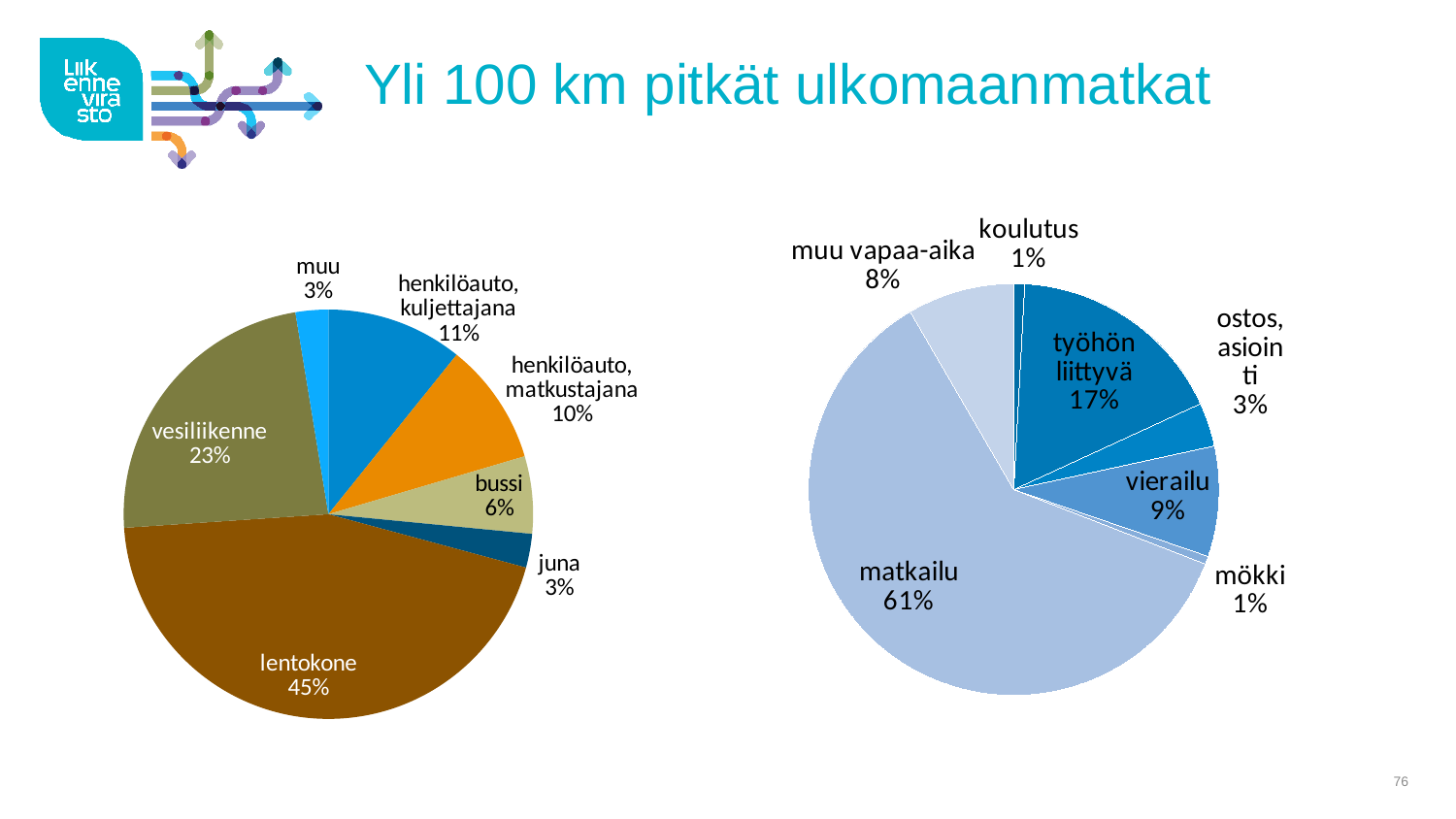
In the left pie chart, which category has the largest share? lentokone In the left pie chart, what is the share for vesiliikenne? 23% How many slices does the left pie chart have? 7 In the right pie chart, what is the share for työhön liittyvä? 17% In the left pie chart, which is larger: bussi or juna? bussi In the right pie chart, which category has the largest share? matkailu In the right pie chart, what share does matkailu have? 61% What type of chart is shown on the right side of the slide? pie chart In the left pie chart, what is the difference between the shares of henkilöauto, kuljettajana and henkilöauto, matkustajana? 1 percentage point In the right pie chart, what is the difference between the shares of vierailu and muu vapaa-aika? 1 percentage point In the left pie chart, what share does lentokone have? 45% What is the title of the slide? Yli 100 km pitkät ulkomaanmatkat